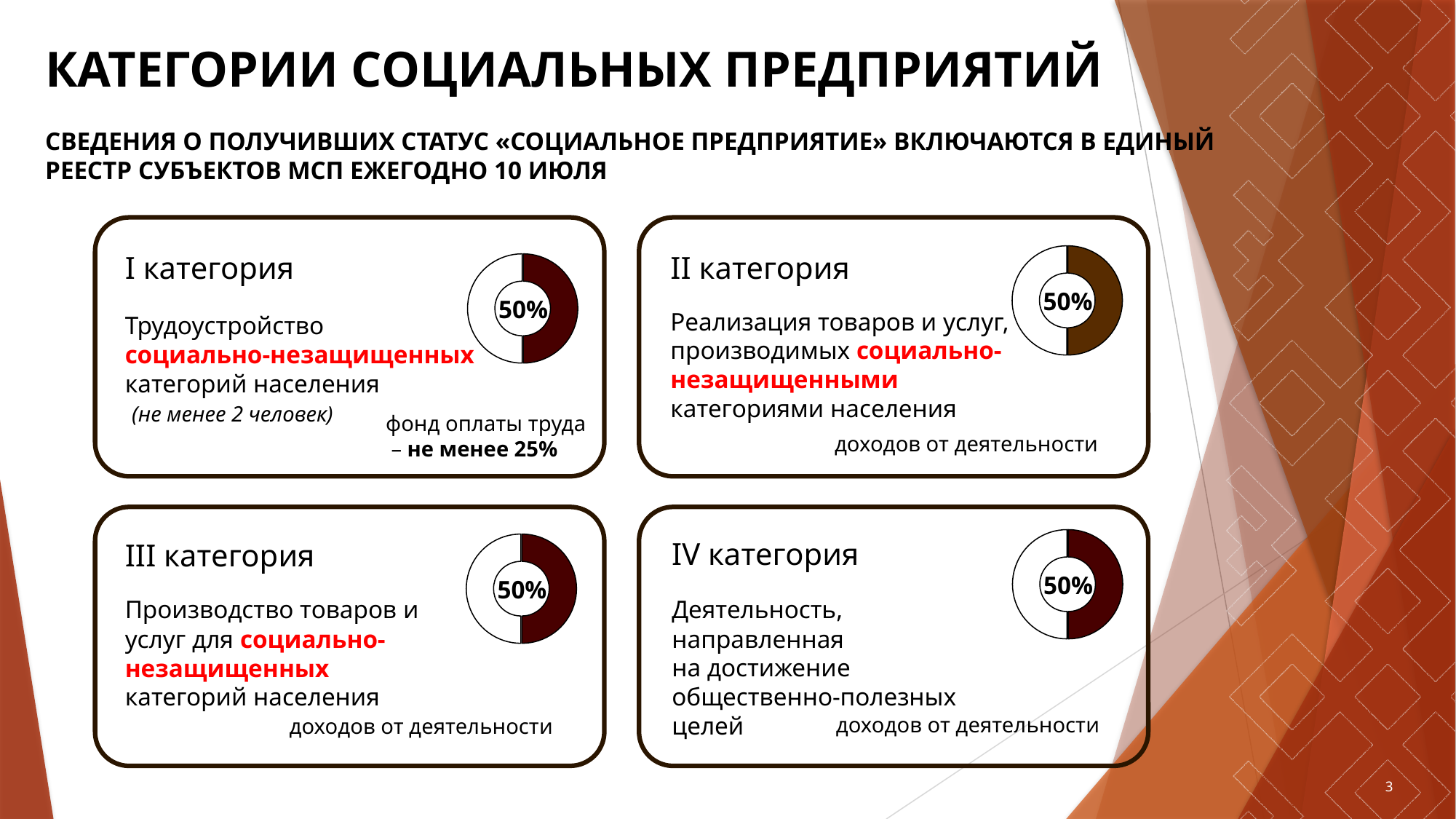
In the chart in the "IV категория" box, is the filled slice greater or less than 25%? greater In the chart in the "II категория" box, what value is printed in the centre of the doughnut? 50% Do all four doughnut charts on the slide show the same percentage value? Yes In the chart in the "IV категория" box, what percentage is displayed? 50% In the chart in the "I категория" box, what share of the doughnut does the filled (dark) slice represent? 50% In the chart in the "III категория" box, is the filled slice greater or less than 75%? less What kind of chart is shown in each of the four category boxes? Doughnut chart On which side of each doughnut chart is the filled slice located? Right In the chart in the "III категория" box, what percentage is displayed? 50% Which category box contains the doughnut chart whose filled slice is brown rather than dark maroon? II категория How many doughnut charts are on the slide? 4 In the chart in the "I категория" box, what percentage is shown in the centre of the doughnut? 50%